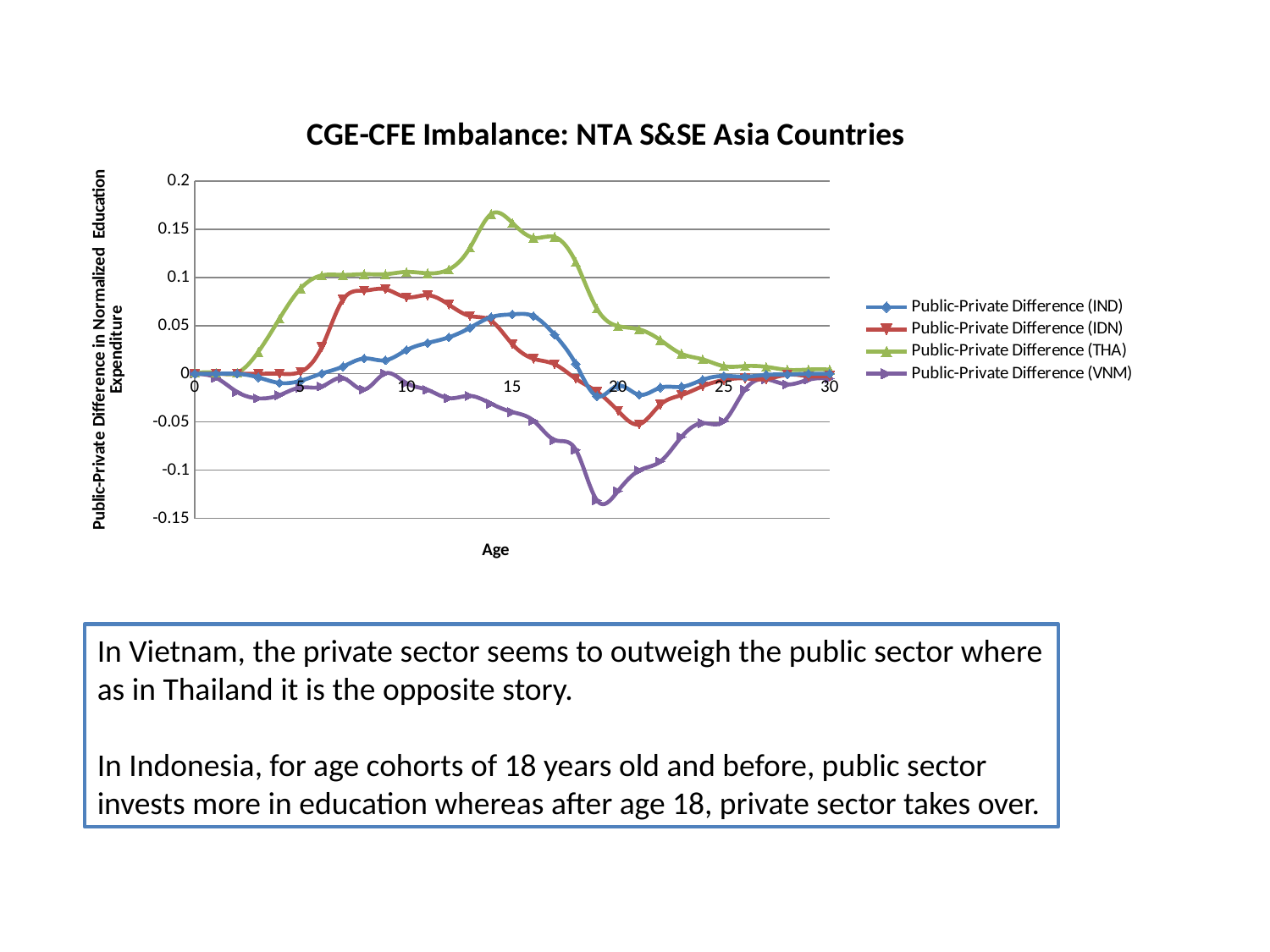
Which series reaches the lowest value on the chart? Public-Private Difference (VNM) Does the Public-Private Difference (THA) series rise or fall between age 14 and age 30? fall Is the value for Public-Private Difference (THA) at age 14 greater or less than 0.15? greater At age 10, which is larger: Public-Private Difference (THA) or Public-Private Difference (IND)? Public-Private Difference (THA) What is the title of the chart? CGE-CFE Imbalance: NTA S&SE Asia Countries What is the label of the x axis? Age What kind of chart is shown on the slide? line chart At age 20, which is larger: Public-Private Difference (IND) or Public-Private Difference (VNM)? Public-Private Difference (IND) Is the value for Public-Private Difference (IDN) at age 8 greater or less than 0.05? greater How many series does the legend list? 4 Which series reaches the highest value on the chart? Public-Private Difference (THA) Is the value for Public-Private Difference (VNM) at age 19 greater or less than -0.1? less